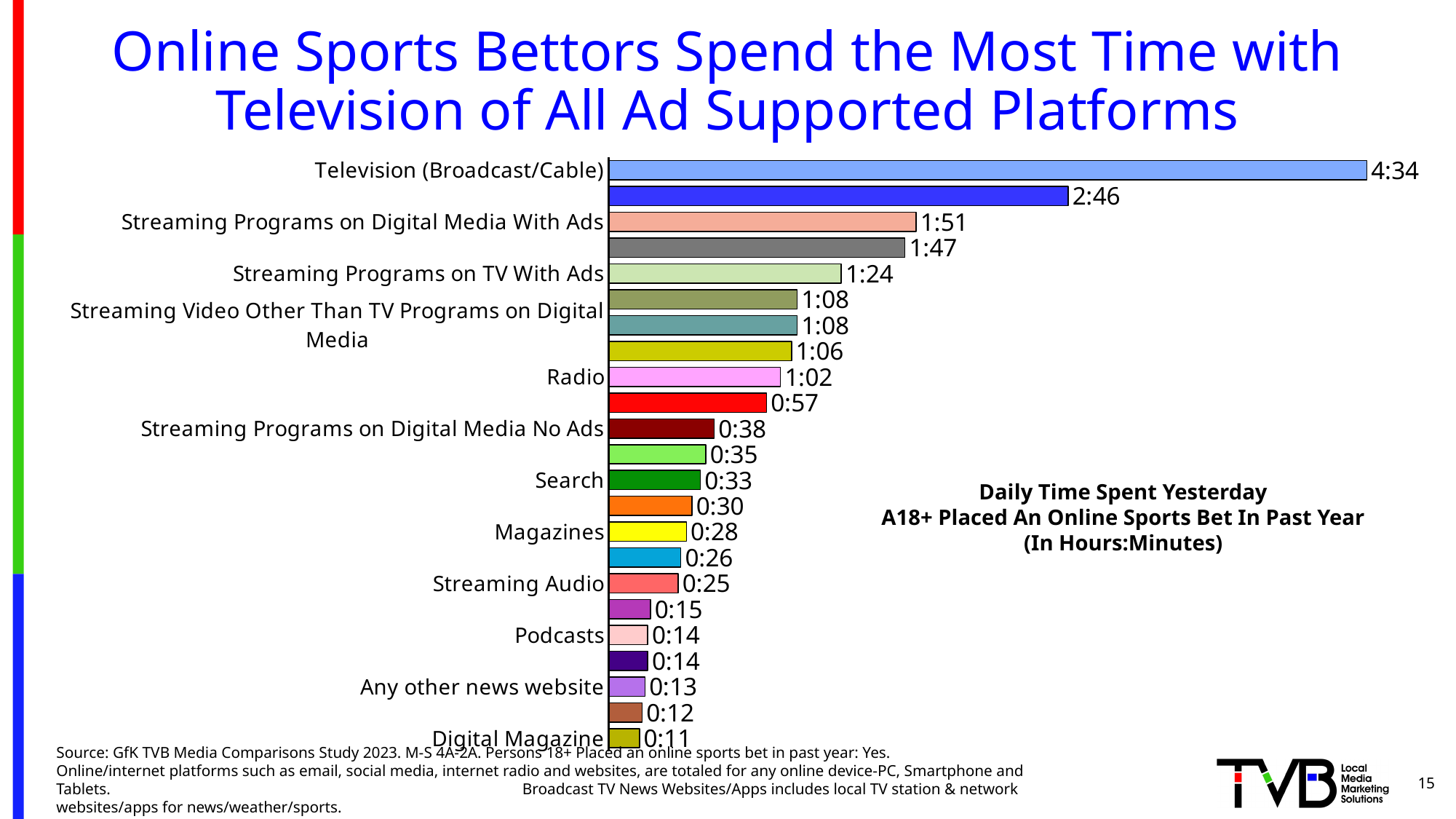
What kind of chart is shown on the slide? Bar chart What is the value for Search? 0:33 What is the daily time spent with Television (Broadcast/Cable)? 4:34 How many bars are plotted in the chart? 23 What is the value for Streaming Programs on Digital Media With Ads? 1:51 Which has a larger value, Magazines or Streaming Audio? Magazines Which labeled platform has the lowest daily time spent? Digital Magazine What is the value for Digital Magazine? 0:11 What is the value for Radio? 1:02 How much more time is spent with Television (Broadcast/Cable) than with Radio? 3:32 What is the value for Streaming Programs on TV With Ads? 1:24 Which platform has the highest daily time spent? Television (Broadcast/Cable)